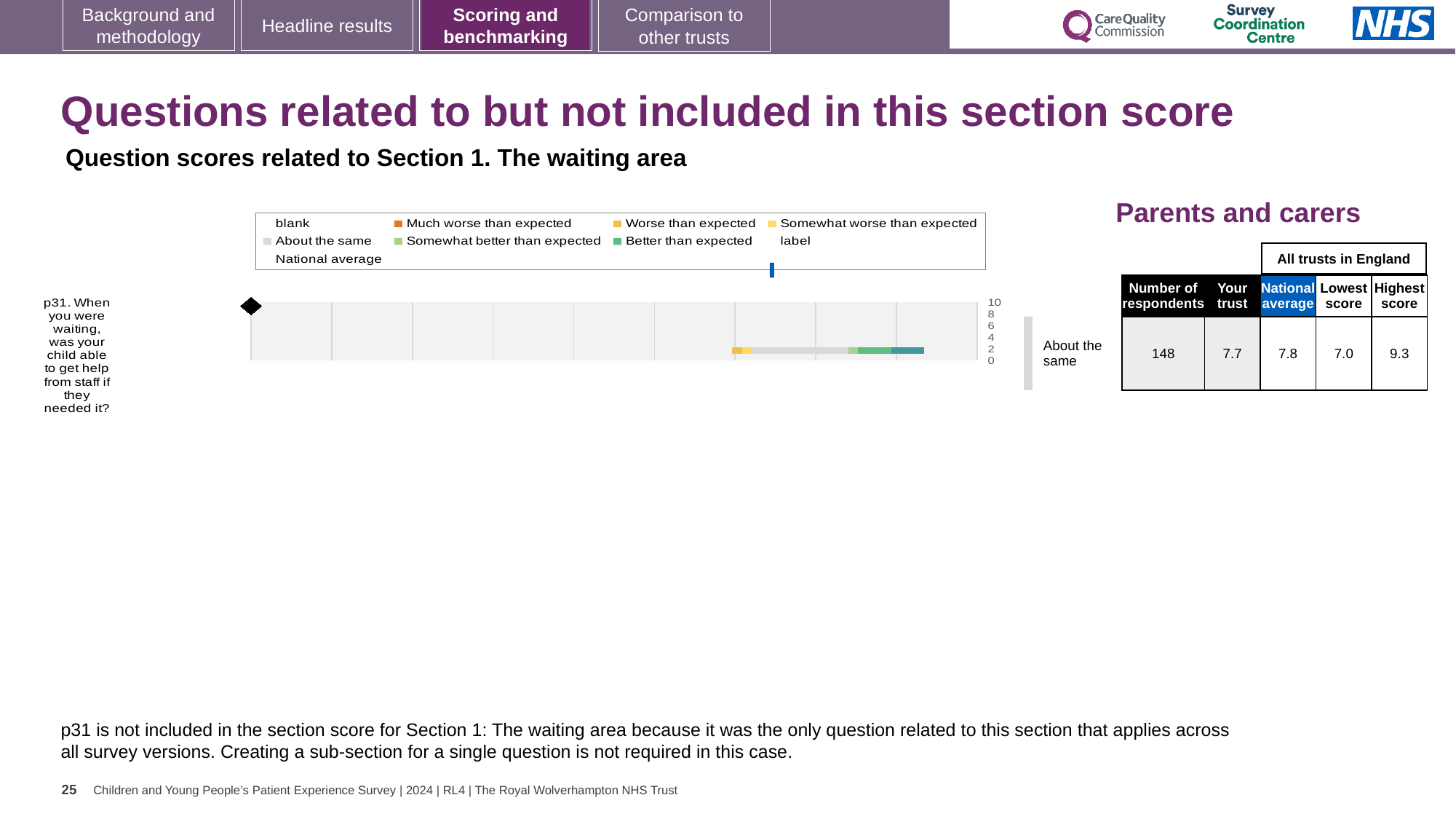
For p31, which is larger: the 'Your trust' score or the national average? National average In the table beside the chart, what is the 'Your trust' score for p31? 7.7 In the table beside the chart, what is the lowest score among all trusts in England for p31? 7.0 In the table beside the chart, what is the highest score among all trusts in England for p31? 9.3 What kind of chart is used to show the p31 question score? bar chart For p31, what is the difference between the national average and the 'Your trust' score? 0.1 In the table beside the chart, what is the national average score for p31? 7.8 What rating label is shown to the right of the p31 bar? About the same In the table beside the chart, how many respondents answered p31? 148 For p31, what is the difference between the highest score and the lowest score among all trusts in England? 2.3 Which question is plotted in the chart? p31. When you were waiting, was your child able to get help from staff if they needed it? How many survey questions are plotted in the chart? 1